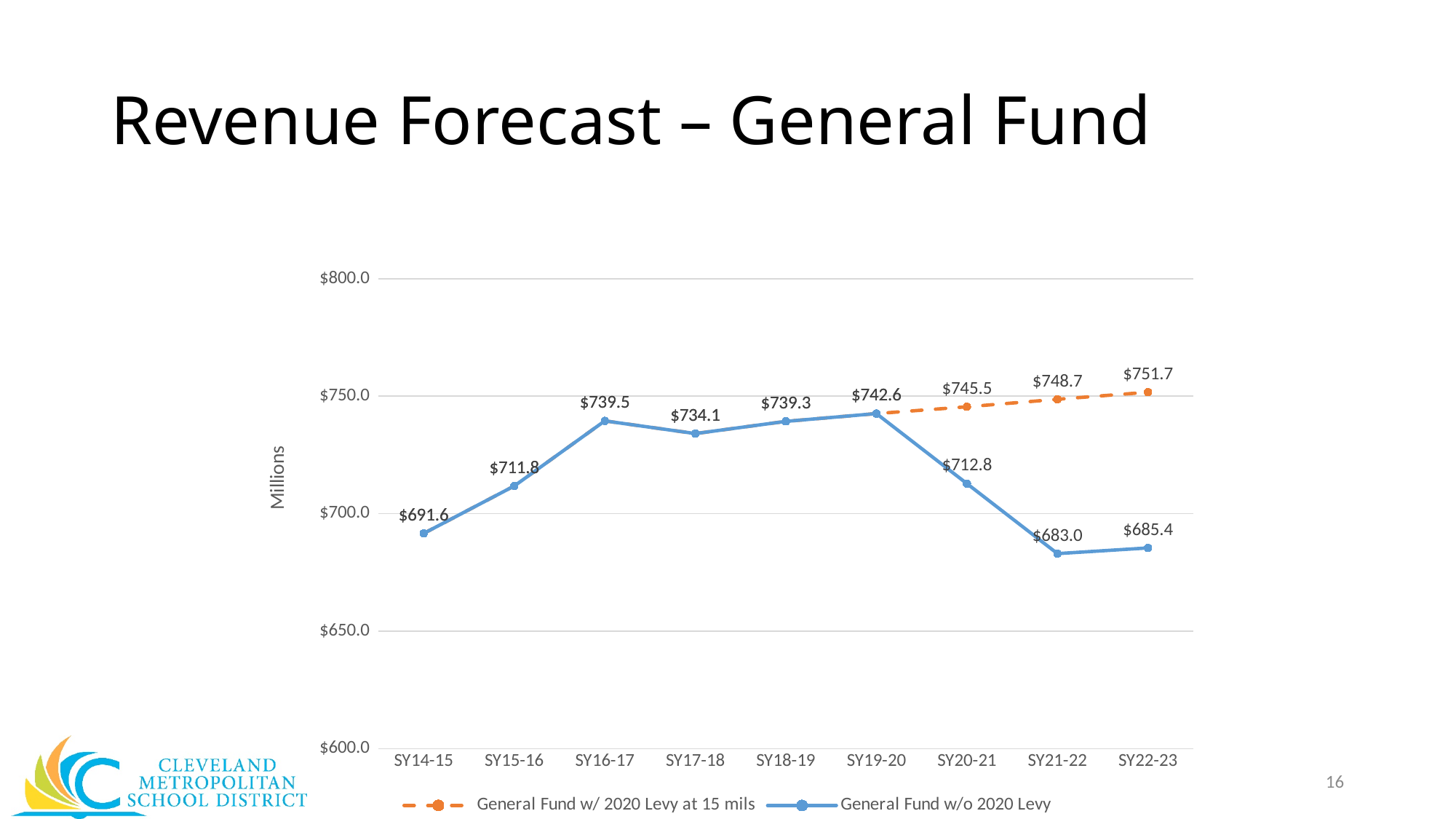
Is the value for General Fund w/o 2020 Levy in SY21-22 greater or less than $700.0? less What is the value for General Fund w/ 2020 Levy at 15 mils in SY22-23? $751.7 In which school year does the General Fund w/o 2020 Levy series reach its highest value? SY19-20 How many series does the legend list? 2 What is the difference between the two series in SY22-23? $66.3 Which series has the larger value in SY21-22? General Fund w/ 2020 Levy at 15 mils What is the value for General Fund w/o 2020 Levy in SY14-15? $691.6 In which school year does the General Fund w/o 2020 Levy series reach its lowest value? SY21-22 What is the value for General Fund w/o 2020 Levy in SY17-18? $734.1 What kind of chart is shown on the slide? Line chart What is the difference between the two series in SY20-21? $32.7 How many school years are shown on the x axis? 9